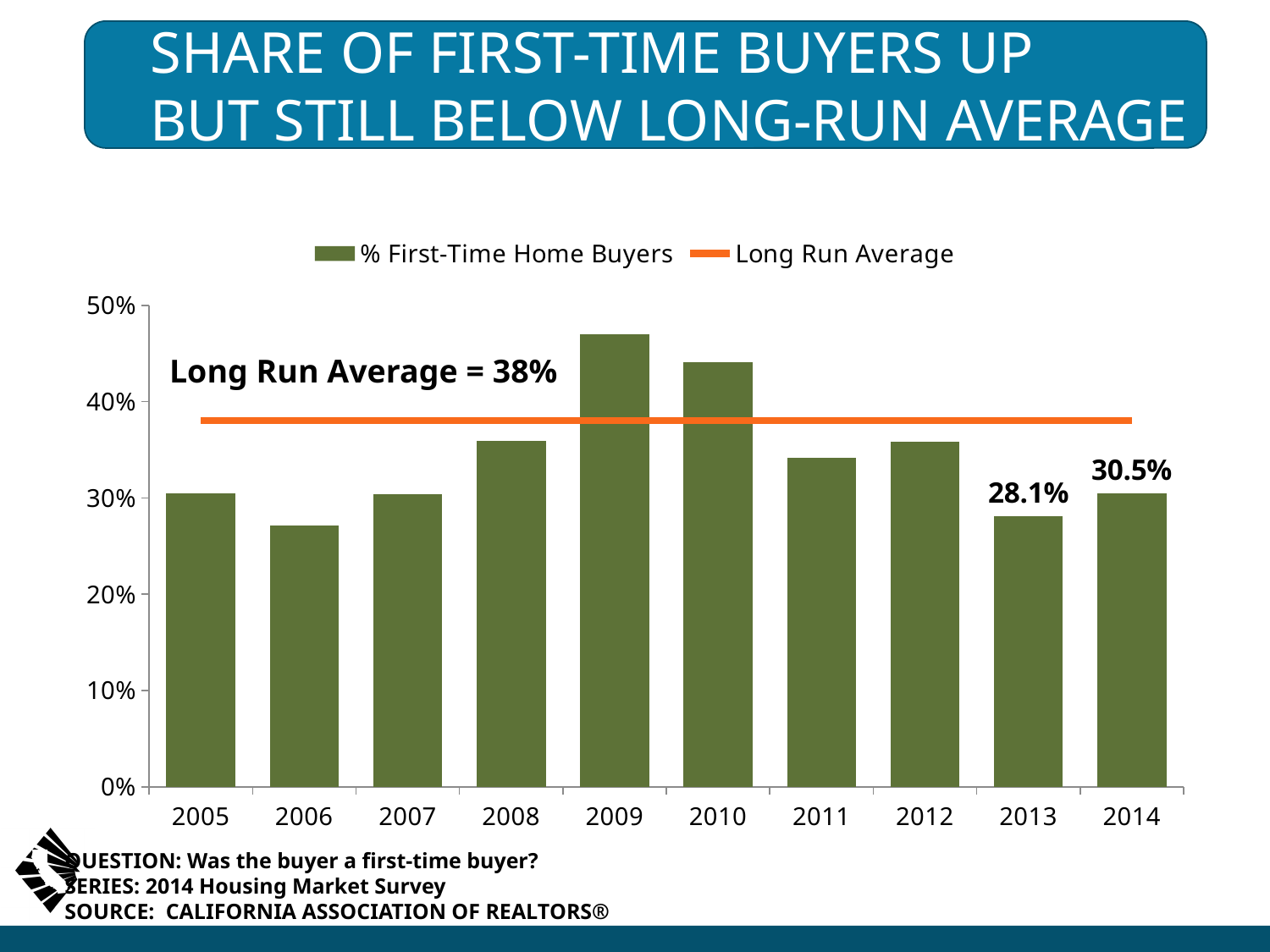
How many years are shown on the x axis? 10 Is the value for 2009 greater or less than 40%? greater By how many percentage points did the share of first-time home buyers rise from 2013 to 2014? 2.4 percentage points Do the values rise or fall from 2010 to 2013? Fall How many series does the legend list? 2 What is the Long Run Average shown on the chart? 38% Which is larger, the value for 2009 or the value for 2010? 2009 Which year has the highest share of first-time home buyers? 2009 What is the value for 2014? 30.5% What is the value for 2013? 28.1% What kind of chart is shown on the slide? Combination bar and line chart Is the value for 2006 greater or less than 30%? less